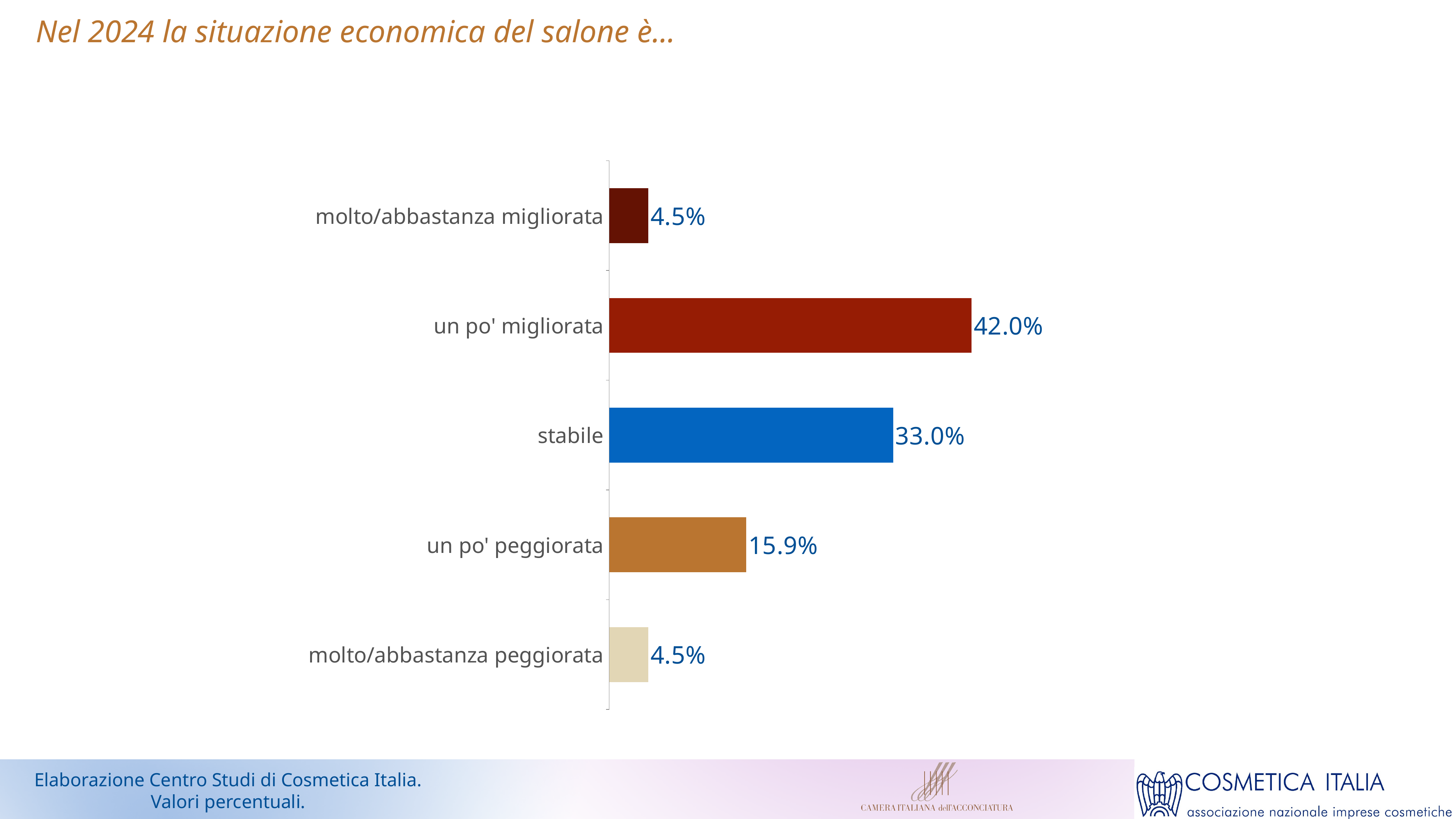
What is the value for 'stabile'? 33.0% What kind of chart is shown on the slide? bar chart What is the title of the slide? Nel 2024 la situazione economica del salone è… What is the difference between 'un po' migliorata' and 'stabile'? 9.0% What is the difference between 'stabile' and 'un po' peggiorata'? 17.1% How many categories are shown in the chart? 5 Which category has the highest value? un po' migliorata What is the value for 'un po' peggiorata'? 15.9% What is the value for 'un po' migliorata'? 42.0% What is the value for 'molto/abbastanza migliorata'? 4.5% What colour is the bar for 'stabile'? blue Which is larger, 'stabile' or 'un po' peggiorata'? stabile